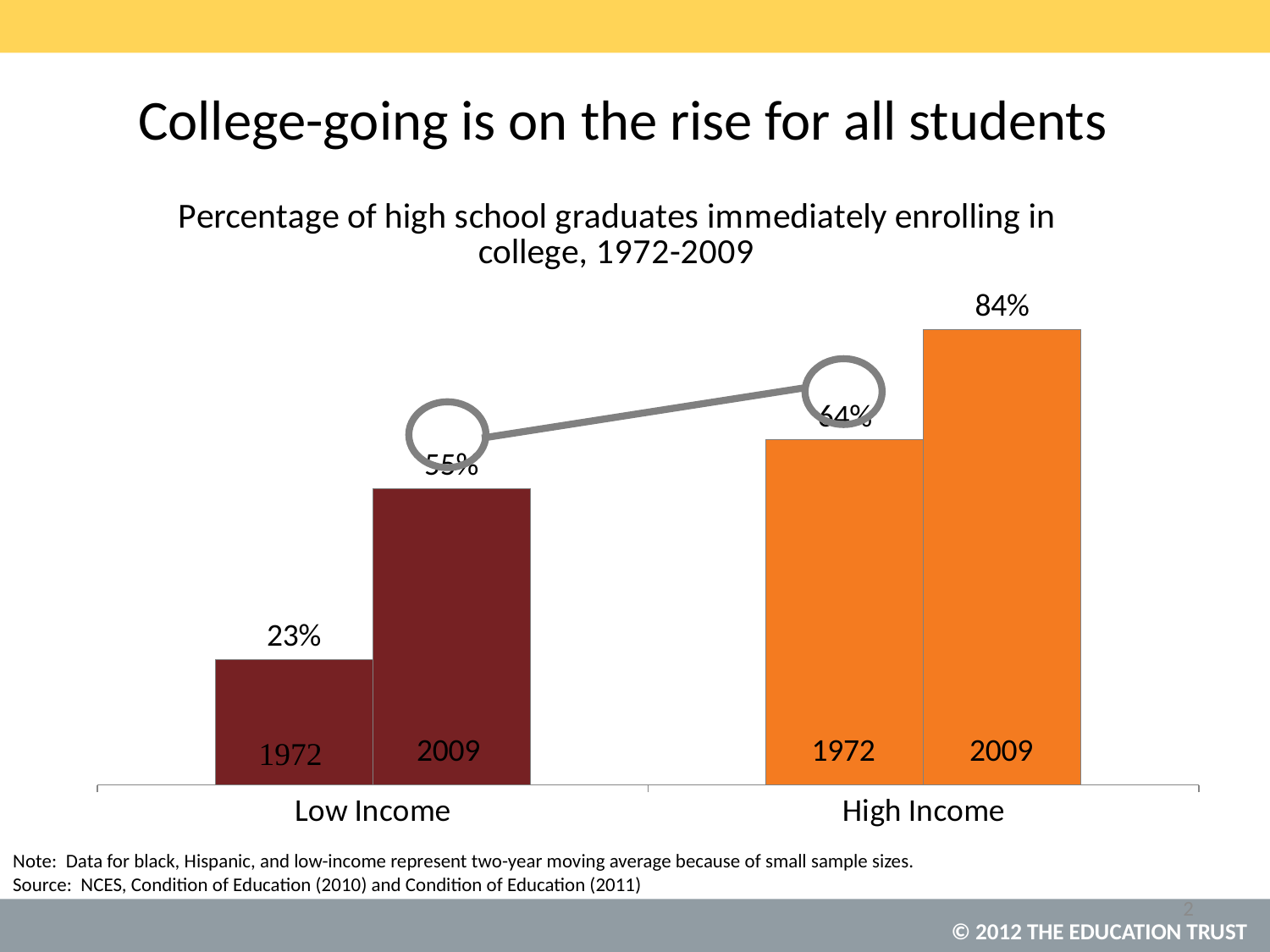
Which is larger: the Low Income value for 2009 or the High Income value for 1972? High Income, 1972 Which bar shows the highest percentage of high school graduates immediately enrolling in college? High Income, 2009 How many income groups are shown on the x axis? 2 What is the value for Low Income in 1972? 23% What is the value for High Income in 2009? 84% For Low Income students, which year has the higher value, 1972 or 2009? 2009 Within each income group, does the percentage rise or fall from 1972 to 2009? Rise What is the difference between the High Income 2009 value and the Low Income 1972 value? 61 percentage points What kind of chart is shown on the slide? Bar chart What is the title of the chart? Percentage of high school graduates immediately enrolling in college, 1972-2009 How many bars are plotted in the chart? 4 Which bar shows the lowest percentage? Low Income, 1972